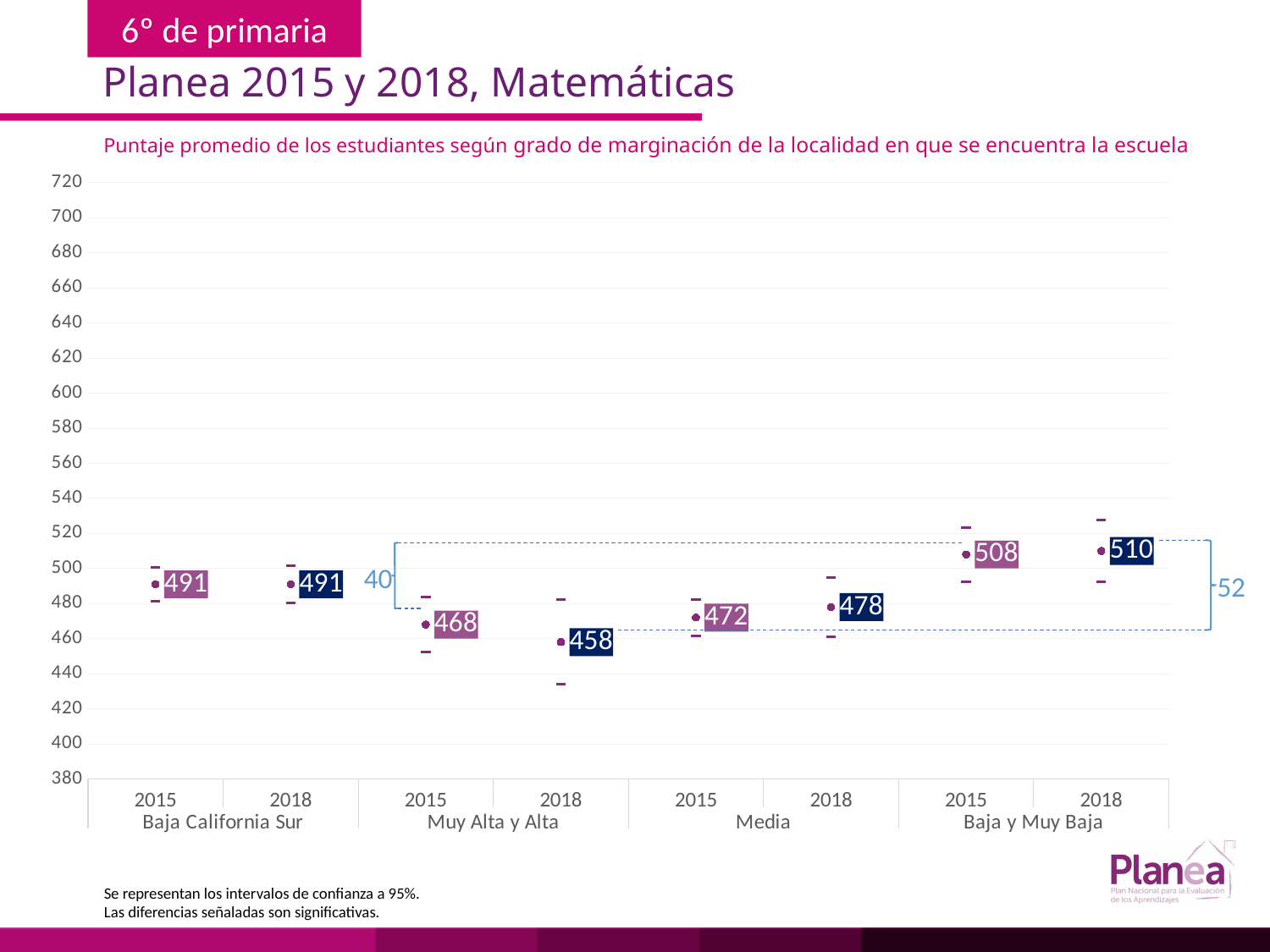
What does the note below the chart say the intervals represent? Intervalos de confianza a 95% What is the 2015 average score for Baja California Sur? 491 How many marginalization groups are shown on the x axis? 4 What is the 2018 average score for Media? 478 Which group and year has the lowest average score? Muy Alta y Alta, 2018 What is the 2015 average score for Baja y Muy Baja? 508 What is the 2018 average score for Muy Alta y Alta? 458 What is the difference between the 2015 scores of Baja y Muy Baja and Muy Alta y Alta? 40 Which is larger, the 2015 score for Media or the 2018 score for Media? 2018 (478) What is the difference between the 2018 scores of Baja y Muy Baja and Muy Alta y Alta? 52 Which group and year has the highest average score? Baja y Muy Baja, 2018 Did the average score for Muy Alta y Alta rise or fall from 2015 to 2018? fall